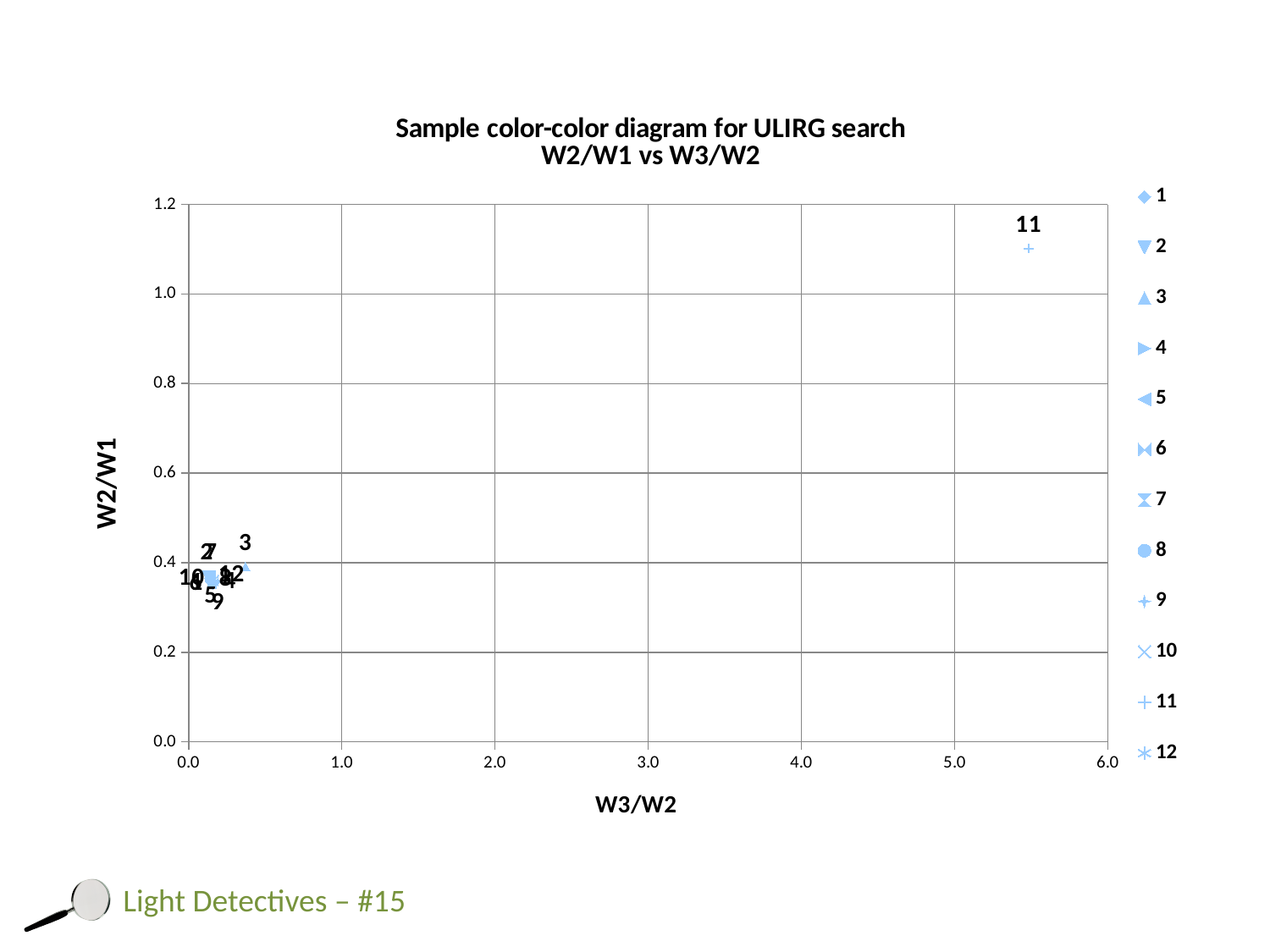
Is the W3/W2 value for series 3 greater or less than 1.0? less How many series does the legend list? 12 Is the W3/W2 value for series 11 greater or less than 5.0? greater What kind of chart is shown on the slide? scatter chart Which has the larger W2/W1 value, series 3 or series 11? 11 Which series has the highest W3/W2 value? 11 Which series has the highest W2/W1 value? 11 What is the title of the chart? Sample color-color diagram for ULIRG search W2/W1 vs W3/W2 What is the label of the horizontal axis? W3/W2 Is the W2/W1 value for series 3 greater or less than 0.6? less Which has the larger W3/W2 value, series 11 or series 3? 11